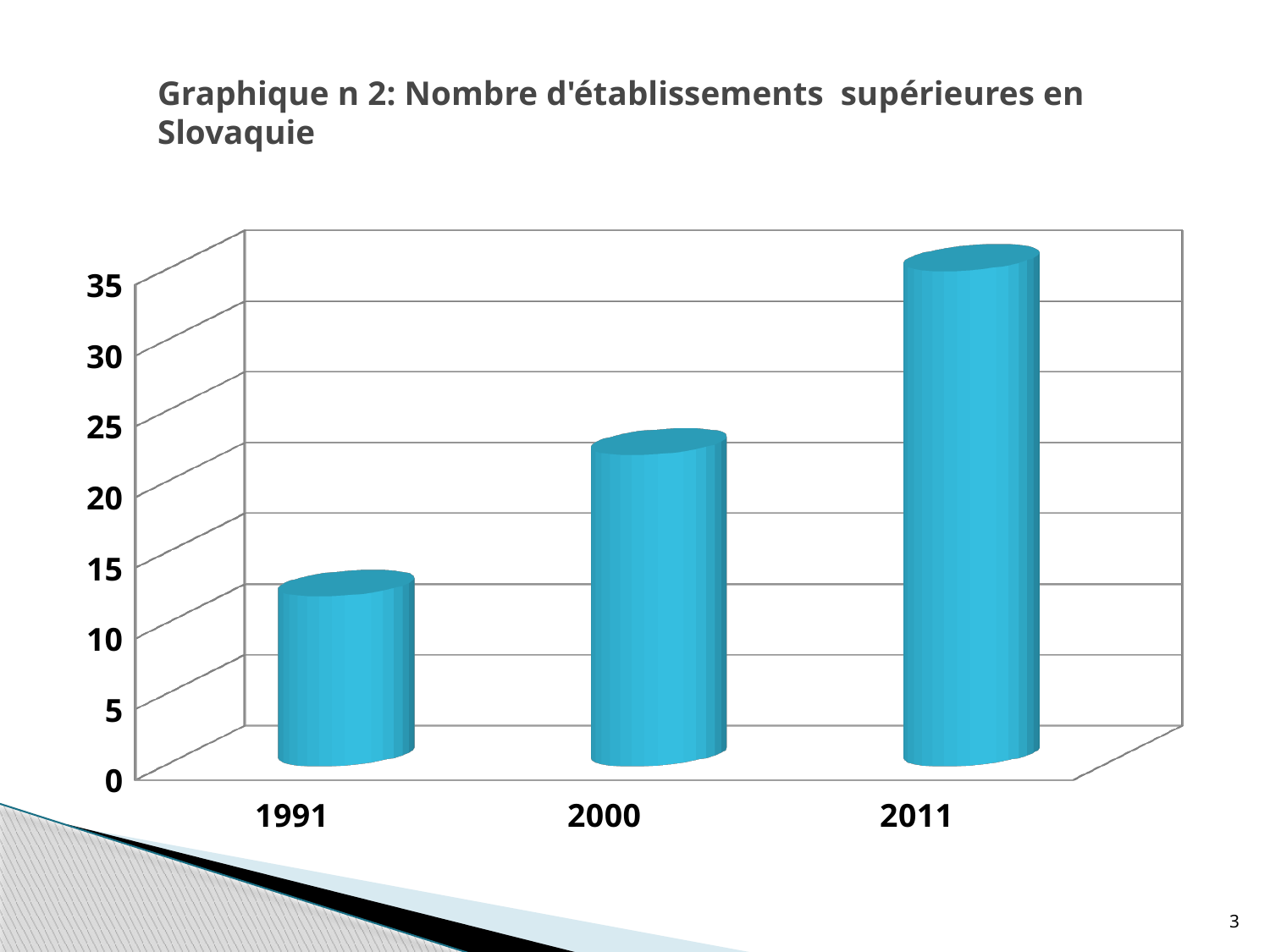
Do the values rise or fall from 1991 to 2011? rise Is the value for 2000 greater or less than 20? greater Is the value for 1991 greater or less than 10? greater Which year has the larger value, 1991 or 2000? 2000 Is the value for 1991 greater or less than 15? less What kind of chart is shown on the slide? bar chart What is the title of the chart on the slide? Graphique n 2: Nombre d'établissements supérieures en Slovaquie Which year has the highest number of higher education establishments? 2011 Which year has the larger value, 2000 or 2011? 2011 How many years are shown on the x axis of the chart? 3 Which year has the lowest number of higher education establishments? 1991